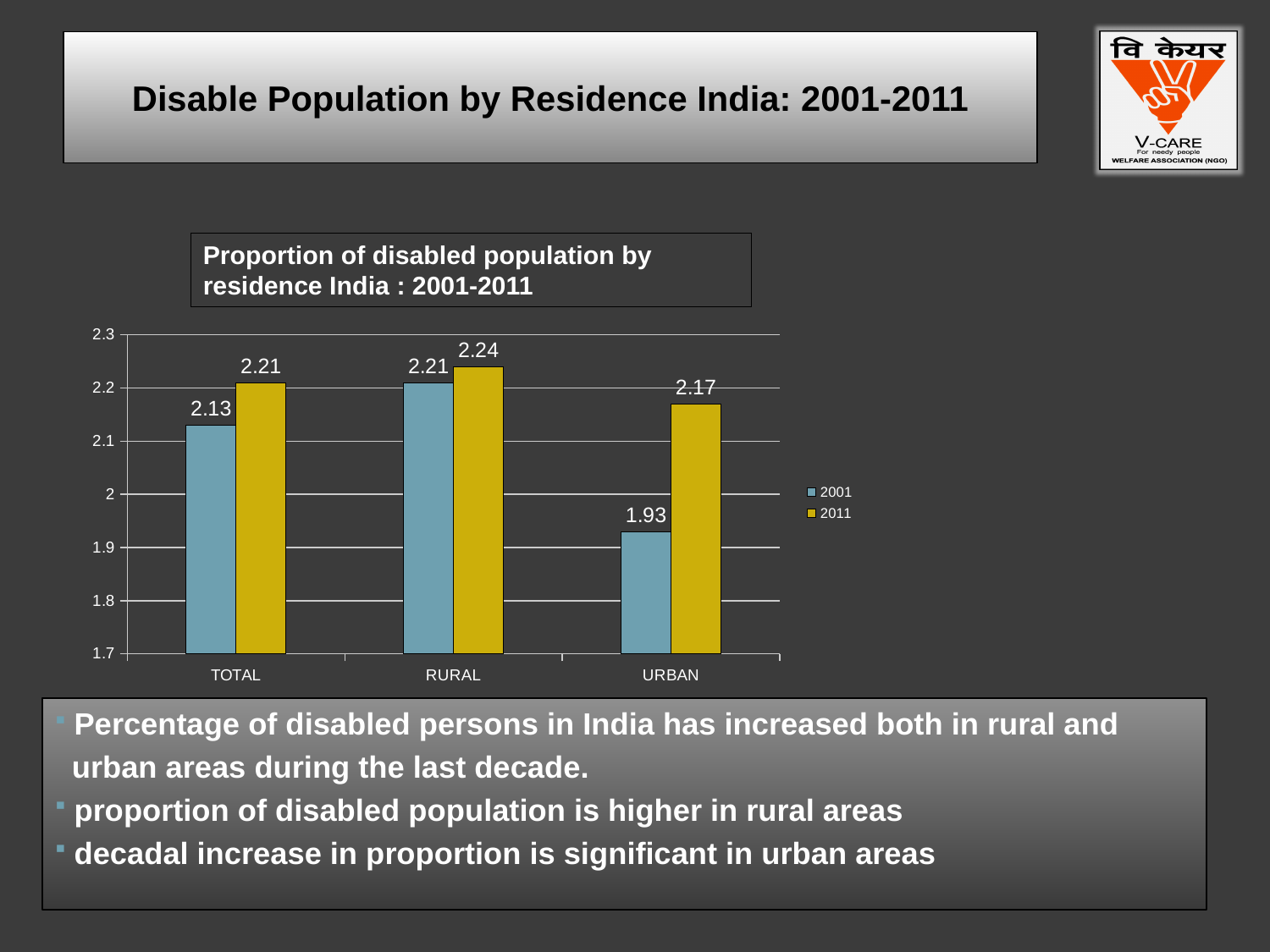
Which category has the highest value in 2011? RURAL What is the difference between the 2011 and 2001 values for URBAN? 0.24 Which is larger, the 2001 value for RURAL or the 2001 value for TOTAL? RURAL What is the value for URBAN in 2011? 2.17 Which category has the lowest value in 2001? URBAN What kind of chart is shown on the slide? bar chart How many series does the legend list? 2 What is the difference between the RURAL and URBAN values in 2011? 0.07 What is the value for RURAL in 2011? 2.24 How many categories are shown on the x axis? 3 Is the value for URBAN in 2001 greater or less than 2? less What is the value for TOTAL in 2001? 2.13